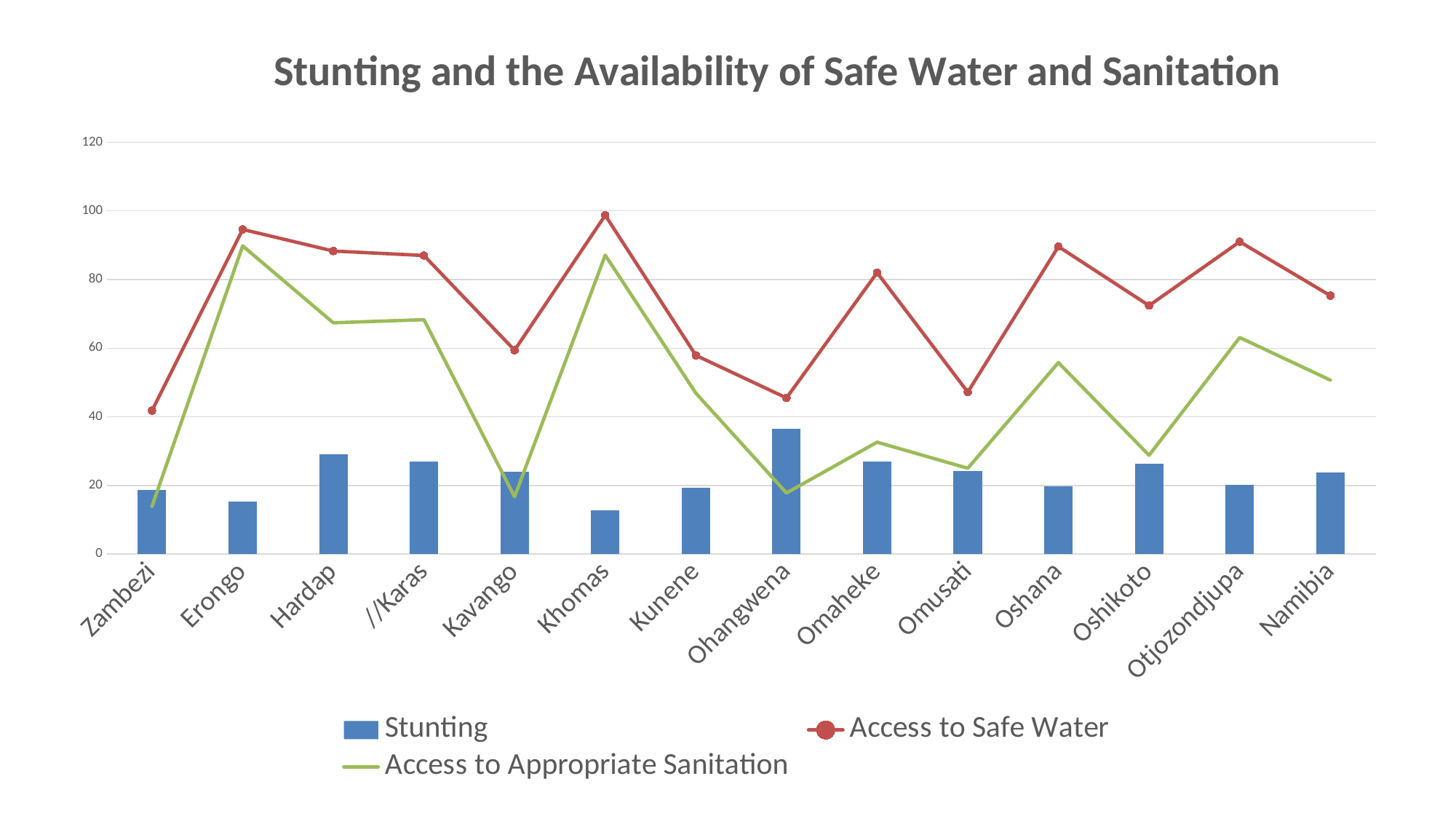
Which region has the highest Access to Safe Water value? Khomas Which region has the lowest Stunting value? Khomas How many regions are shown on the x axis? 14 Which has the larger Access to Safe Water value, Erongo or Kavango? Erongo Is the Stunting value for Ohangwena greater or less than 20? greater How many series does the legend list? 3 Which region has the highest Access to Appropriate Sanitation value? Erongo Is the Access to Safe Water value for Zambezi greater or less than 60? less Which region has the highest Stunting value? Ohangwena Is the Access to Appropriate Sanitation value for Erongo greater or less than 80? greater What is the title of the chart? Stunting and the Availability of Safe Water and Sanitation Which region has the lowest Access to Safe Water value? Zambezi